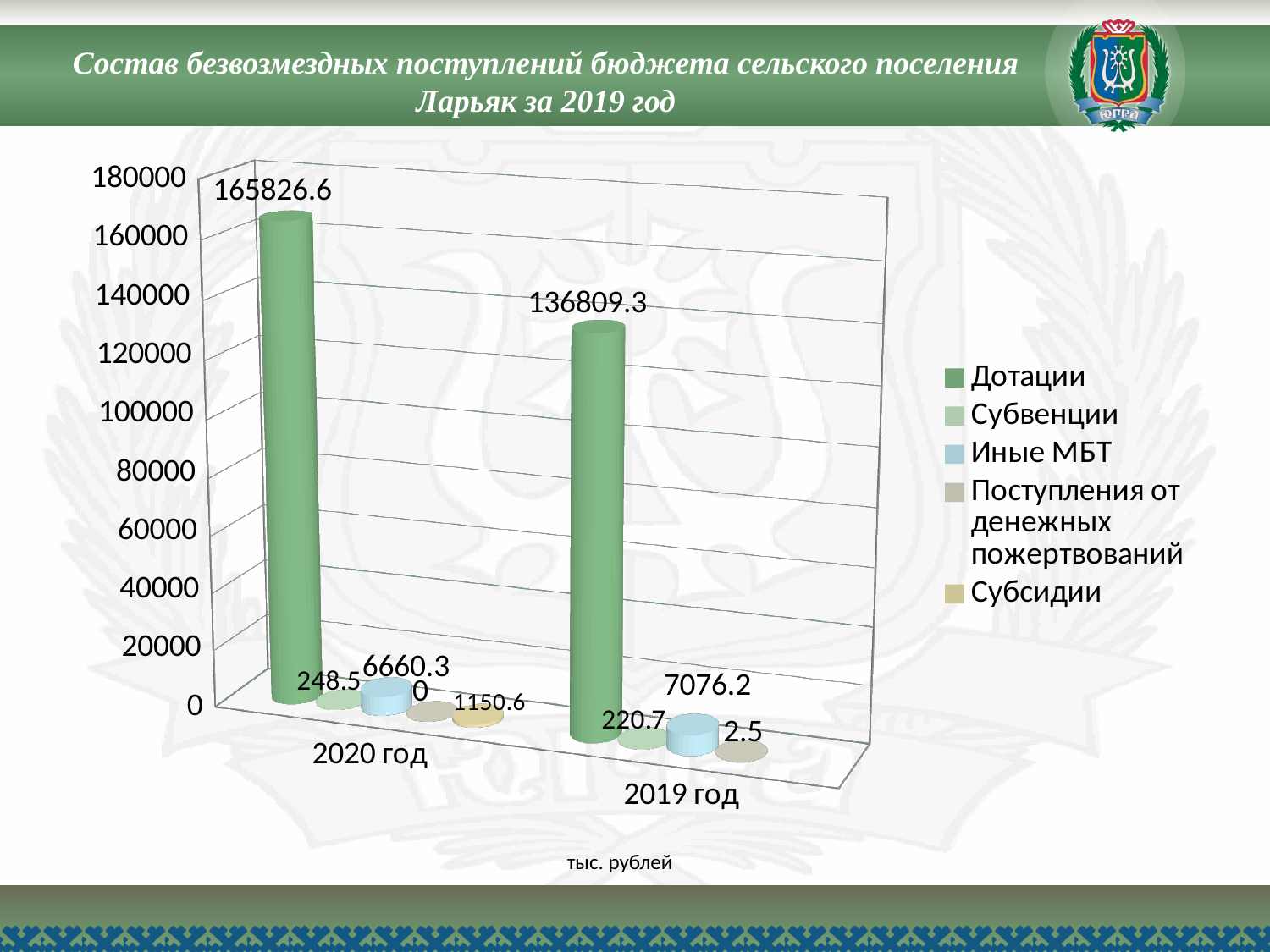
What is the difference between the Иные МБТ values for 2019 год and 2020 год? 415.9 How many series does the legend list? 5 How many categories are shown on the x axis? 2 What is the value of Иные МБТ for 2019 год? 7076.2 Which is larger: Субвенции for 2020 год or Субвенции for 2019 год? 2020 год What is the value of Субсидии for 2020 год? 1150.6 What is the value of Дотации for 2019 год? 136809.3 What is the value of Дотации for 2020 год? 165826.6 Which series has the highest value for 2020 год? Дотации What is the value of Поступления от денежных пожертвований for 2019 год? 2.5 What kind of chart is shown on the slide? Bar chart What is the difference between the Дотации values for 2020 год and 2019 год? 29017.3